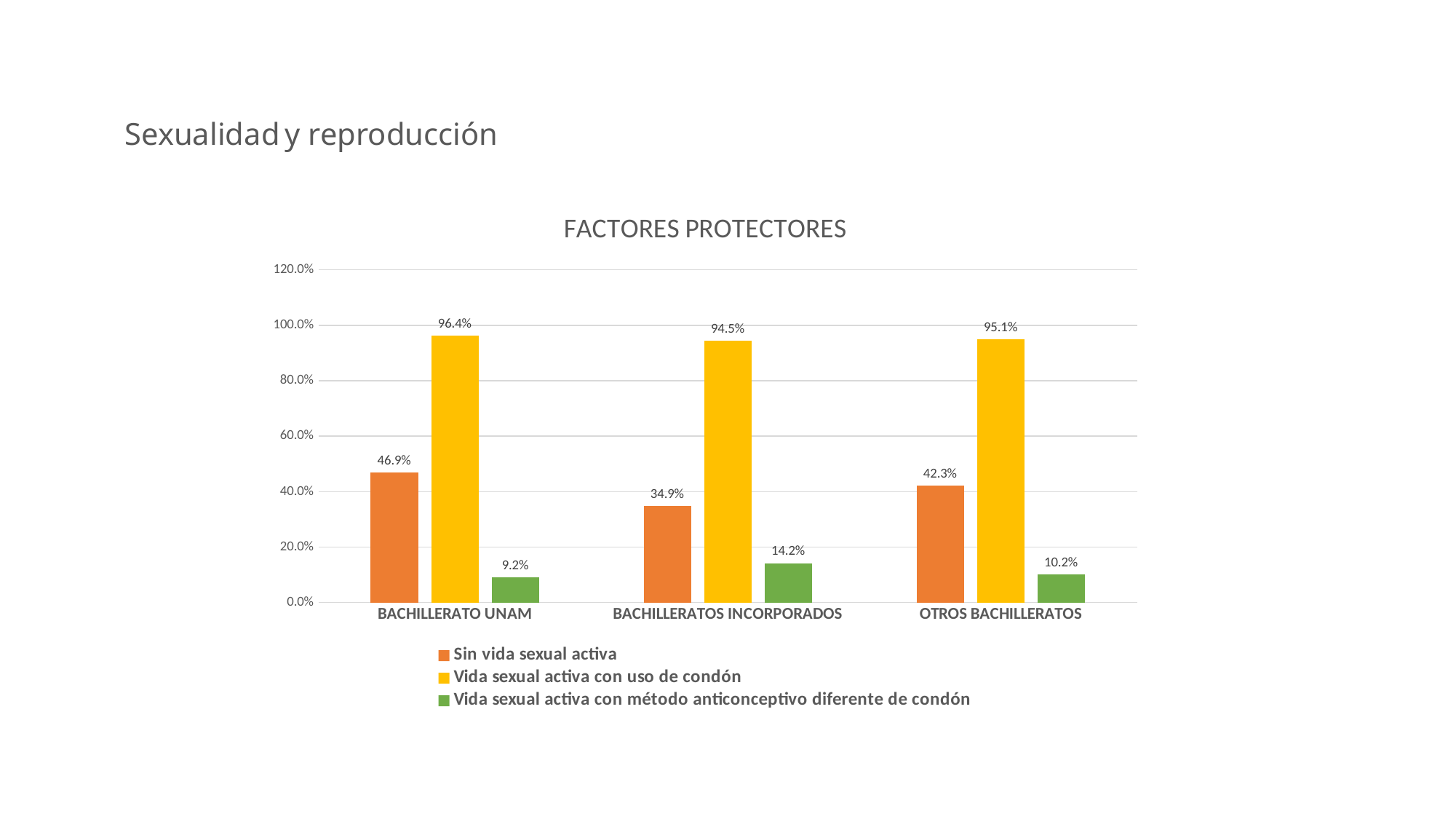
What is the title of the chart? FACTORES PROTECTORES How many series does the legend list? 3 What is the value for 'Sin vida sexual activa' for BACHILLERATO UNAM? 46.9% Is the 'Sin vida sexual activa' value for BACHILLERATOS INCORPORADOS greater or less than 40.0%? less How many categories are shown on the x axis? 3 Which category has the lowest value for 'Sin vida sexual activa'? BACHILLERATOS INCORPORADOS What is the value for 'Vida sexual activa con método anticonceptivo diferente de condón' for OTROS BACHILLERATOS? 10.2% Which is larger: the 'Vida sexual activa con método anticonceptivo diferente de condón' value for BACHILLERATOS INCORPORADOS or for BACHILLERATO UNAM? BACHILLERATOS INCORPORADOS Which category has the highest value for 'Vida sexual activa con uso de condón'? BACHILLERATO UNAM What is the difference between the 'Sin vida sexual activa' values for BACHILLERATO UNAM and OTROS BACHILLERATOS? 4.6% What kind of chart is shown on the slide? Bar chart What is the value for 'Vida sexual activa con uso de condón' for BACHILLERATOS INCORPORADOS? 94.5%